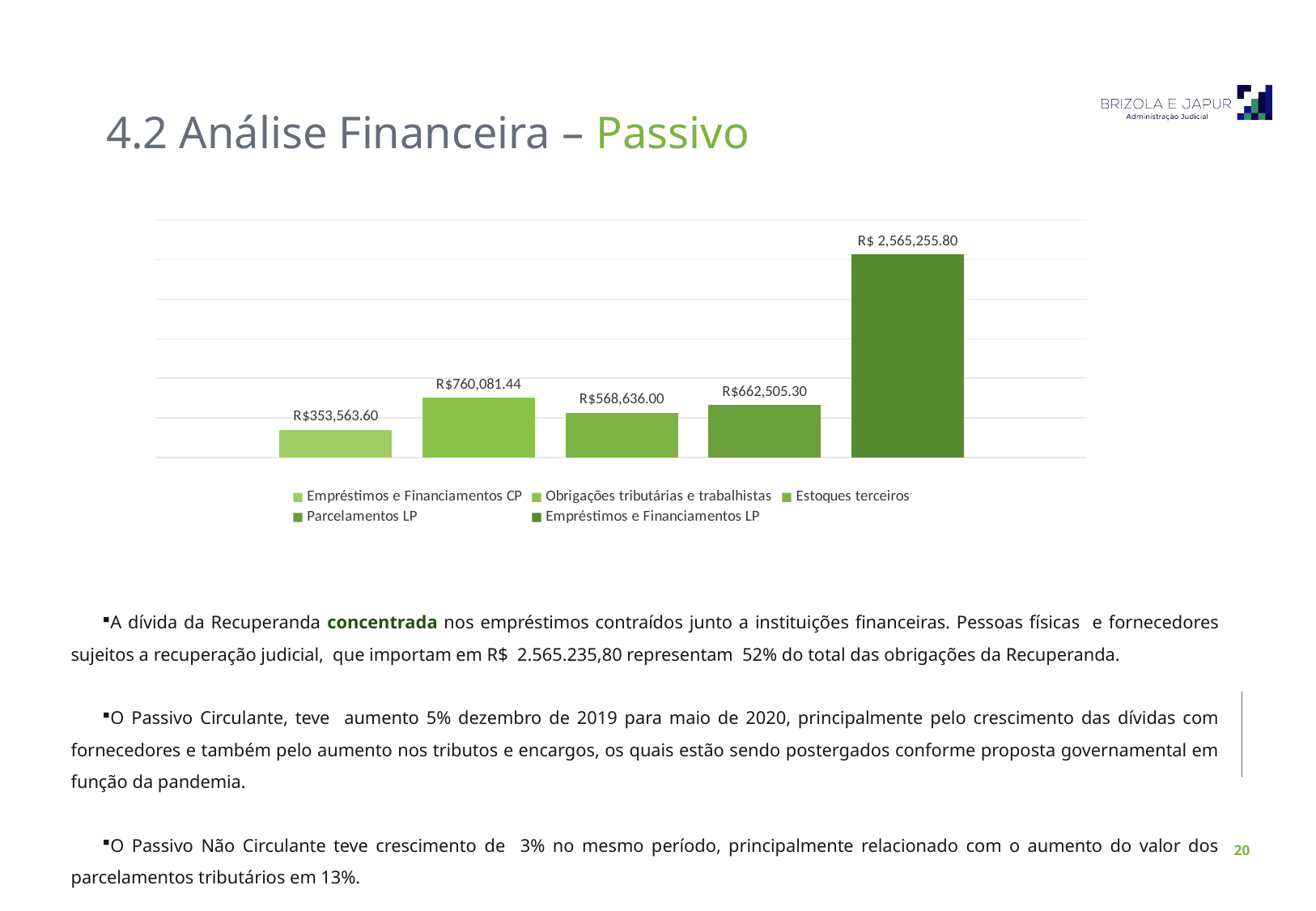
How many bars are plotted in the chart? 5 Which is larger, Parcelamentos LP or Estoques terceiros? Parcelamentos LP What kind of chart is shown on the slide? Bar chart What is the value shown for Obrigações tributárias e trabalhistas? R$760,081.44 Which category has the highest value? Empréstimos e Financiamentos LP What is the difference between Obrigações tributárias e trabalhistas and Empréstimos e Financiamentos CP? R$406,517.84 Which category has the lowest value? Empréstimos e Financiamentos CP What is the value shown for Estoques terceiros? R$568,636.00 How many entries does the legend list? 5 What is the value shown for Parcelamentos LP? R$662,505.30 What is the value shown for Empréstimos e Financiamentos CP? R$353,563.60 What is the value shown for Empréstimos e Financiamentos LP? R$ 2,565,255.80